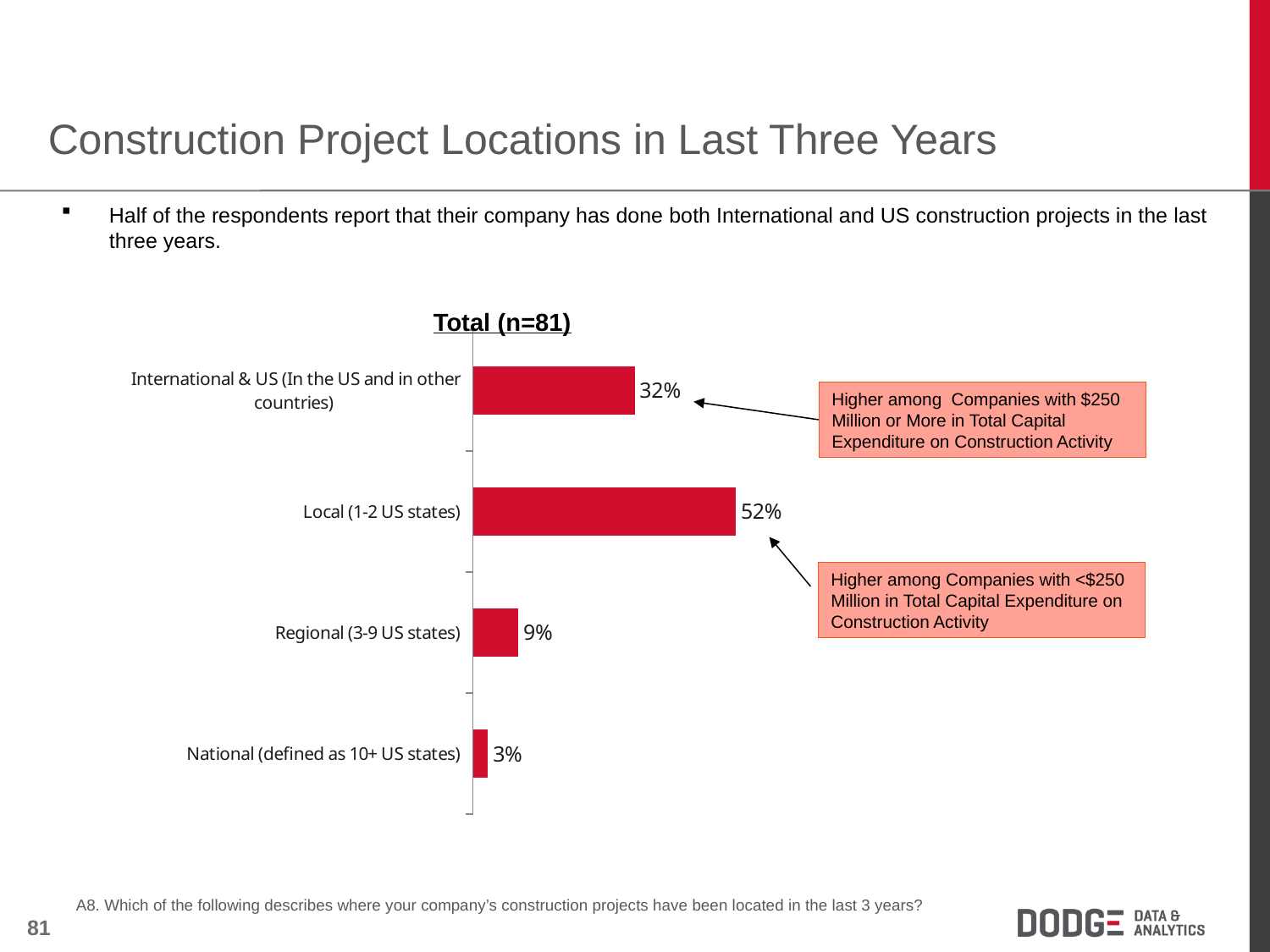
How many categories are shown in the chart? 4 Which category has the lowest value? National (defined as 10+ US states) What is the value for International & US (In the US and in other countries)? 32% What is the difference between the Regional (3-9 US states) value and the National (defined as 10+ US states) value? 6% What is the title of the chart? Total (n=81) Which is larger, the value for Regional (3-9 US states) or the value for International & US? International & US What percentage is shown for Regional (3-9 US states)? 9% What kind of chart is shown on the slide? Bar chart What percentage of respondents report Local (1-2 US states) construction project locations? 52% What is the value for National (defined as 10+ US states)? 3% Which category has the highest value? Local (1-2 US states) What is the difference between the Local (1-2 US states) value and the International & US value? 20%